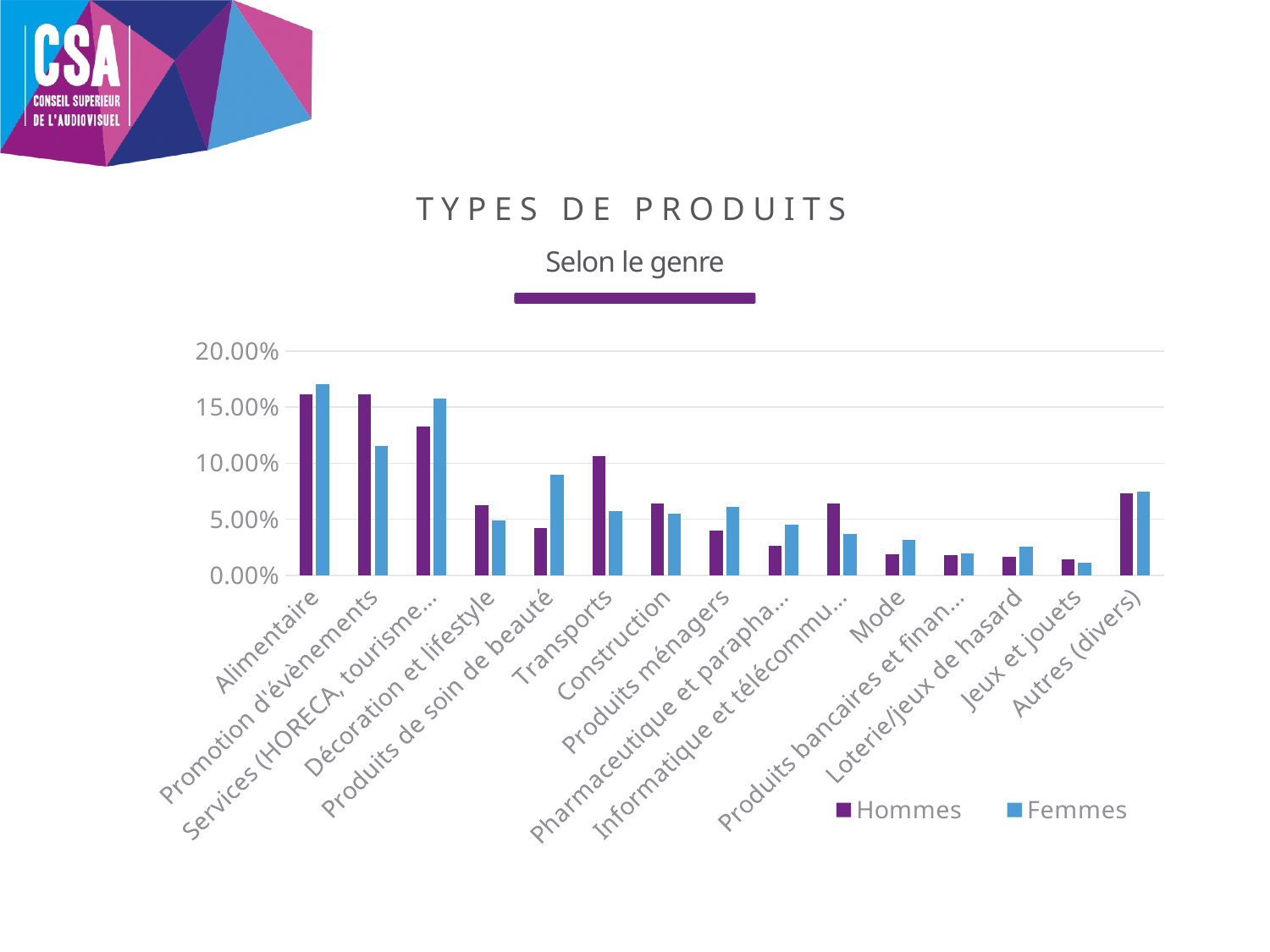
How many series does the legend list? 2 For Transports, which is larger: the Hommes value or the Femmes value? Hommes What is the subtitle shown under the chart title 'TYPES DE PRODUITS'? Selon le genre Is the Hommes value for Promotion d'évènements greater or less than 15.00%? greater How many product categories are shown on the x axis? 15 Is the Hommes value for Mode greater or less than 5.00%? less What are the two series named in the legend? Hommes and Femmes Which category has the highest value for Femmes? Alimentaire What type of chart is shown on the slide? bar chart For Promotion d'évènements, which is larger: the Hommes value or the Femmes value? Hommes Which category has the lowest value for Femmes? Jeux et jouets For Produits de soin de beauté, which is larger: the Hommes value or the Femmes value? Femmes